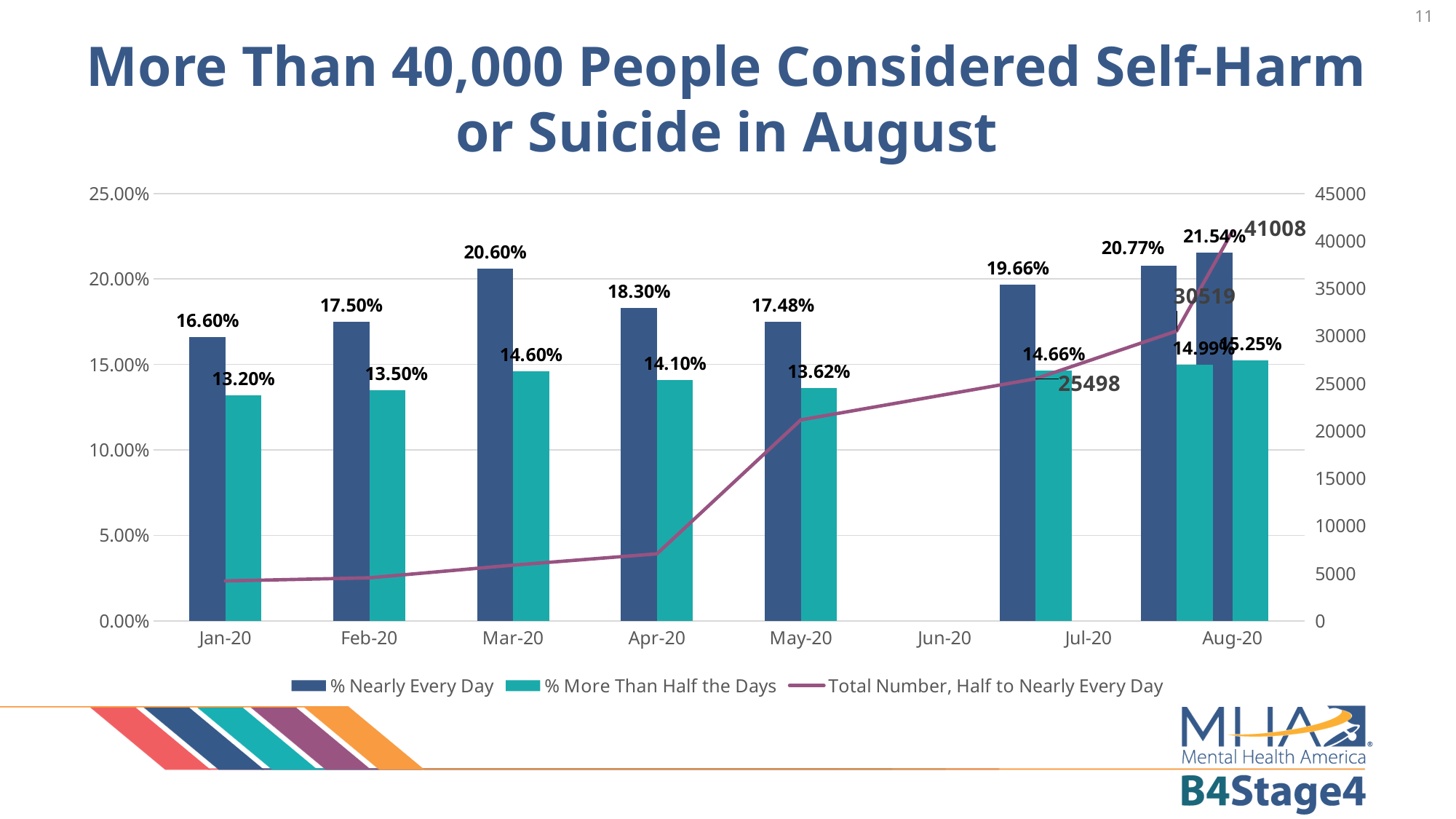
What kind of chart is shown on the slide? Combination bar and line chart What is the value of % Nearly Every Day for May-20? 17.48% What is the highest value shown on the Total Number, Half to Nearly Every Day line? 41008 What is the value of % Nearly Every Day for Jan-20? 16.60% Is the Total Number, Half to Nearly Every Day value for Jan-20 greater or less than 10000? less How many months are labelled on the x axis? 8 Which month has the lowest value for % More Than Half the Days? Jan-20 Which is larger, % Nearly Every Day in Mar-20 or in Apr-20? Mar-20 What is the difference between % Nearly Every Day and % More Than Half the Days in Mar-20? 6.00% What is the highest value of the % Nearly Every Day series? 21.54% How many series does the legend list? 3 What is the value of % More Than Half the Days for Mar-20? 14.60%